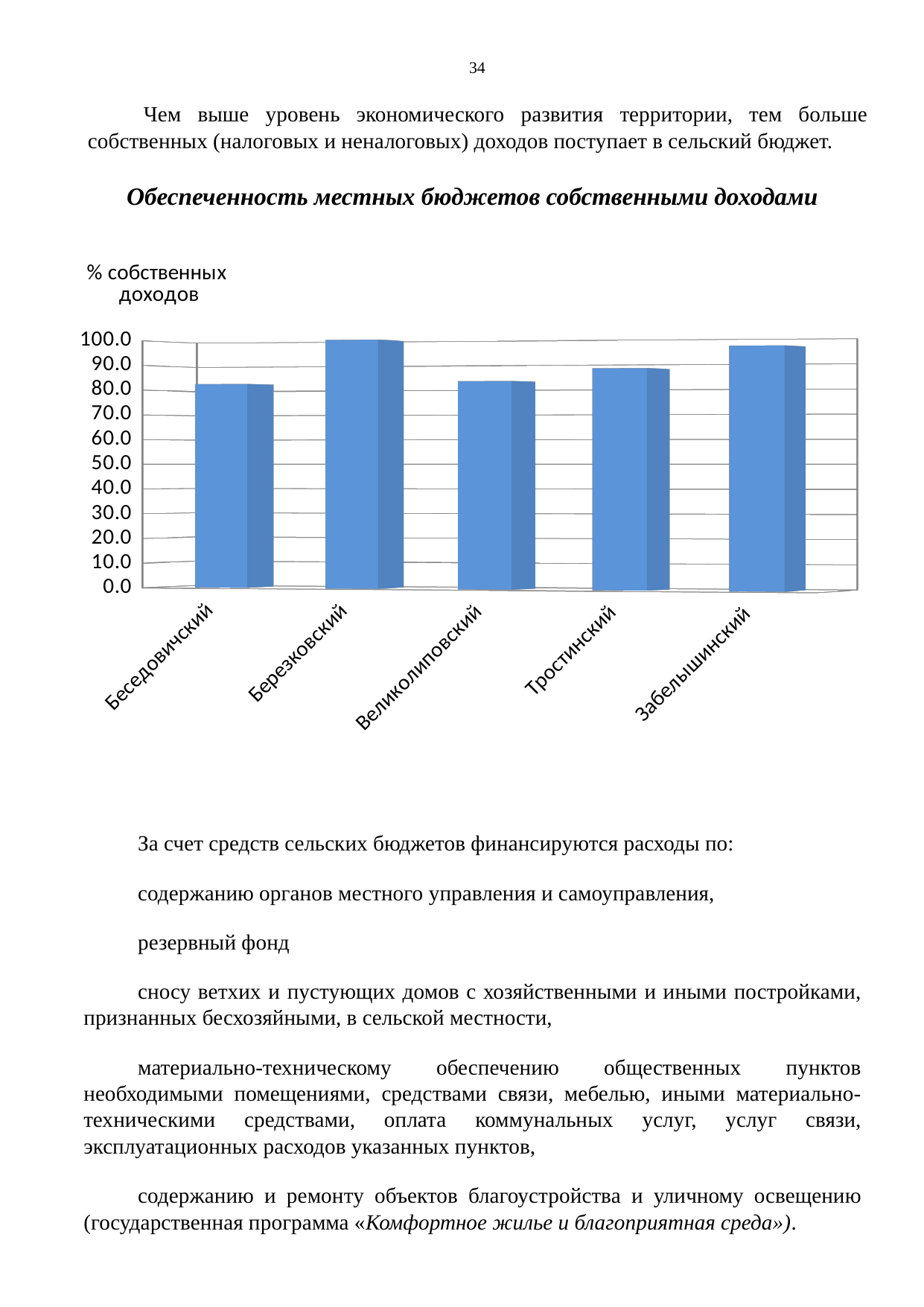
Is the value for Беседовичский greater or less than 90? less Is the value for Тростинский greater or less than 80? greater How many categories (rural councils) are shown on the chart? 5 Is the value for Великолиповский greater or less than 90? less Which is larger, the value for Забельшинский or the value for Великолиповский? Забельшинский What is the label on the vertical axis of the chart? % собственных доходов What is the title of the chart? Обеспеченность местных бюджетов собственными доходами Which is larger, the value for Тростинский or the value for Беседовичский? Тростинский Which category has the highest value on the chart? Березковский What kind of chart is shown on the slide? bar chart